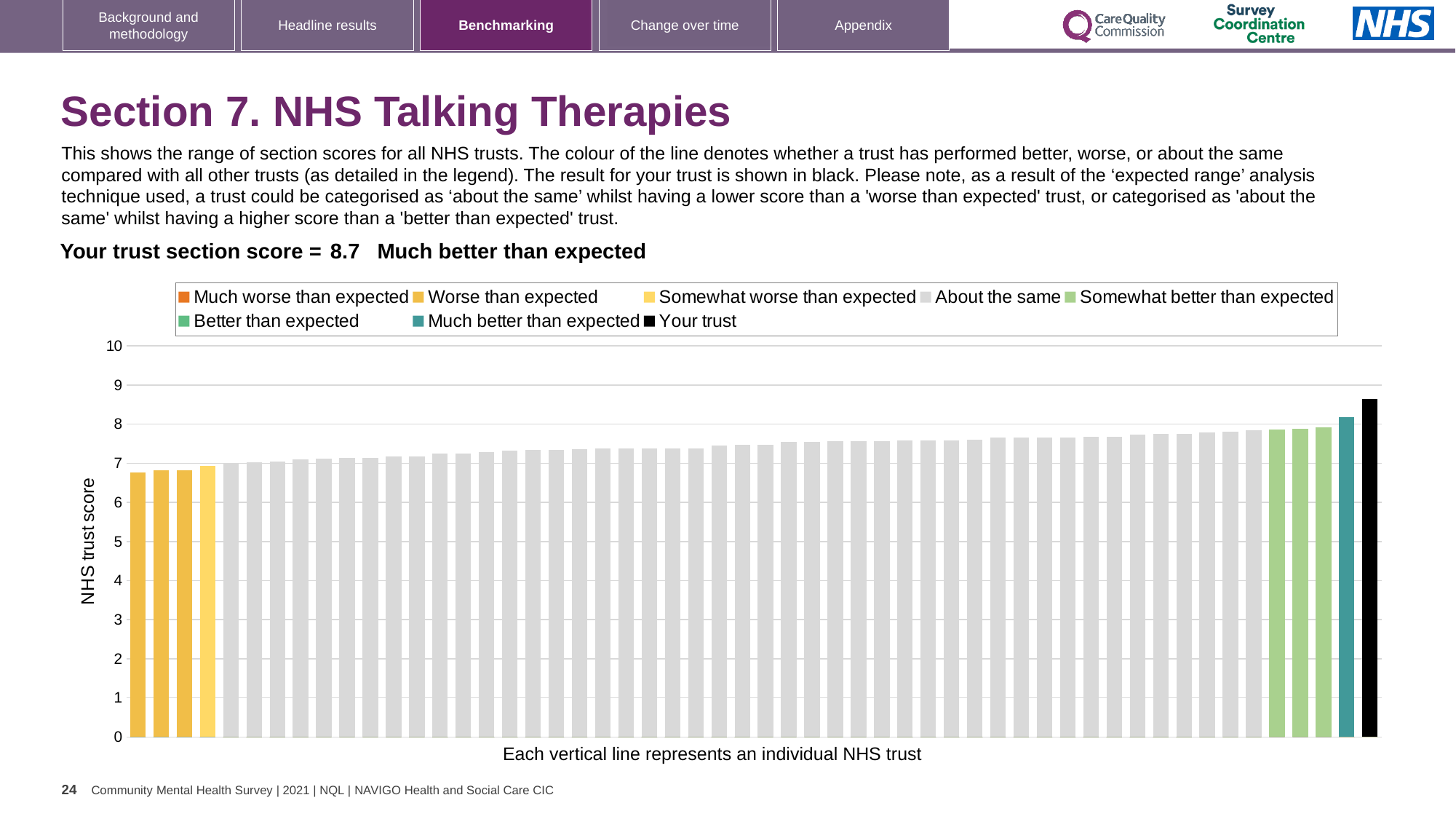
What is the section score for your trust? 8.7 How many bars are coloured as 'Much better than expected' (teal)? 1 Do the bar values rise or fall from left to right along the x axis? rise What colour is the bar for your trust? black How many entries does the chart legend list? 8 How many bars are coloured as 'Somewhat better than expected' (light green)? 3 Is the value for your trust greater or less than 8? greater Which bar in the chart is the highest? Your trust What is the label on the y axis of the chart? NHS trust score Which category is your trust's section score placed in? Much better than expected What kind of chart is shown on the slide? bar chart Is the value for the leftmost bar greater or less than 7? less